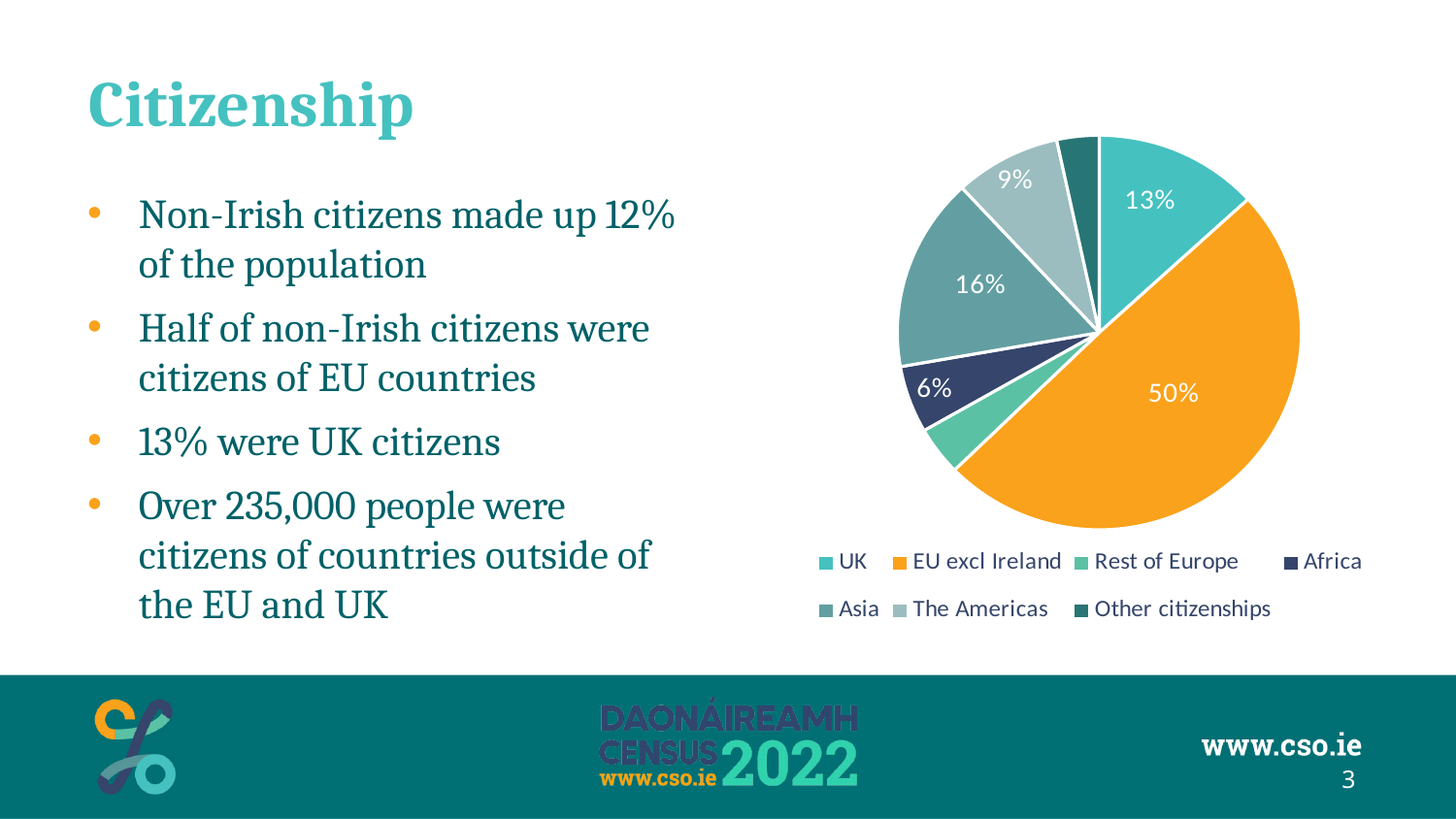
What percentage is shown for the UK slice? 13% What value is labelled on the Africa slice? 6% What type of chart is shown on the slide? Pie chart How many categories does the legend list? 7 What percentage is shown for The Americas? 9% What value is labelled on the Asia slice? 16% What is the difference in percentage points between the EU excl Ireland slice and the UK slice? 37 Which category is shown in orange in the legend? EU excl Ireland Which category has the largest slice of the pie? EU excl Ireland What share of the pie does EU excl Ireland represent? 50% Which is larger, the UK slice or the Africa slice? UK Which is larger, the Asia slice or The Americas slice? Asia